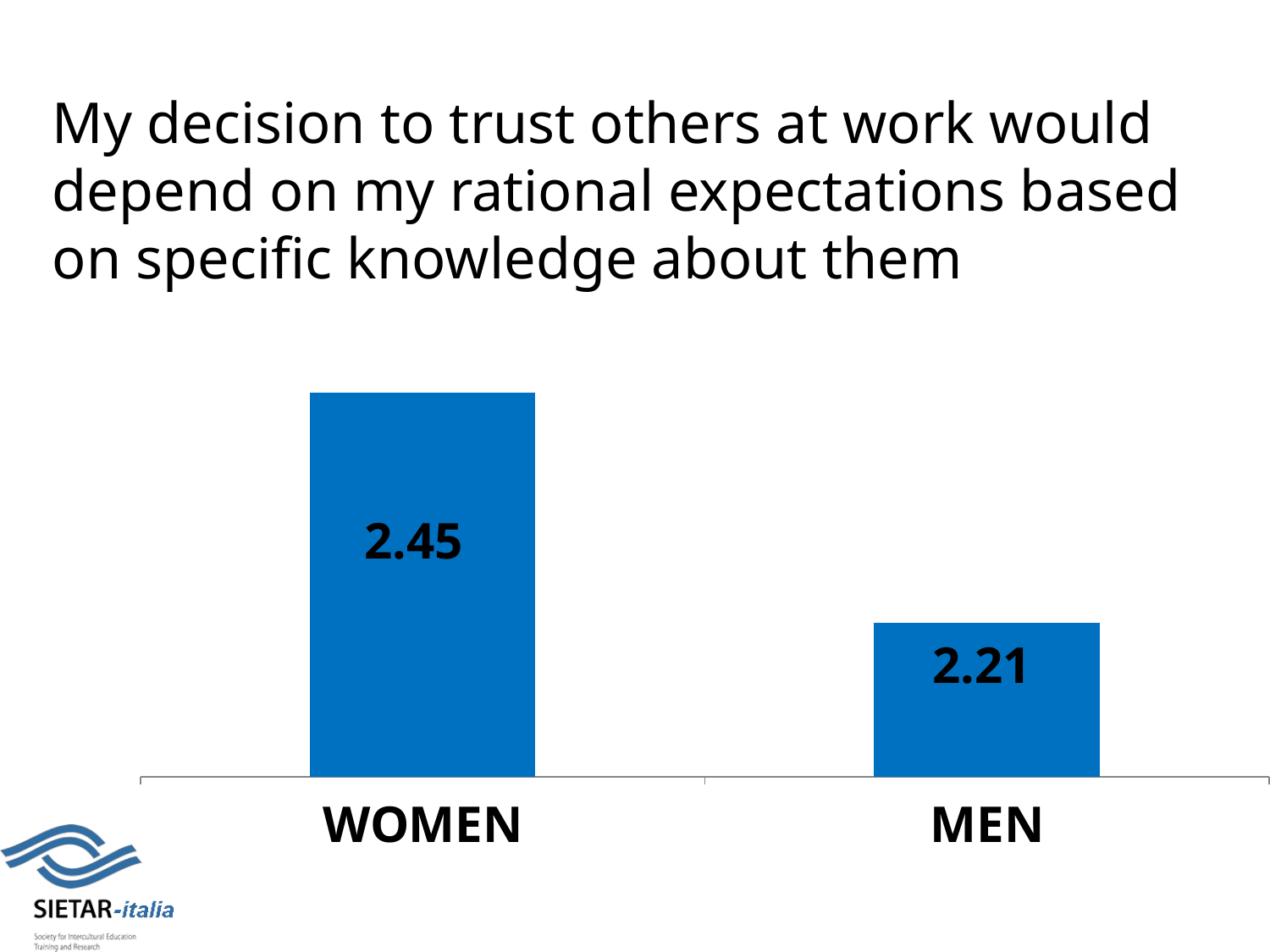
Do the values rise or fall from WOMEN to MEN? Fall How many categories are shown in the chart? 2 Which category has the highest value? WOMEN What colour are the bars in the chart? Blue What is the difference between the values for WOMEN and MEN? 0.24 What kind of chart is shown on the slide? Bar chart What is the value for MEN? 2.21 Which category has the lowest value? MEN What is the value for WOMEN? 2.45 What are the labels of the two categories on the x axis? WOMEN and MEN Which is larger, the value for WOMEN or the value for MEN? WOMEN